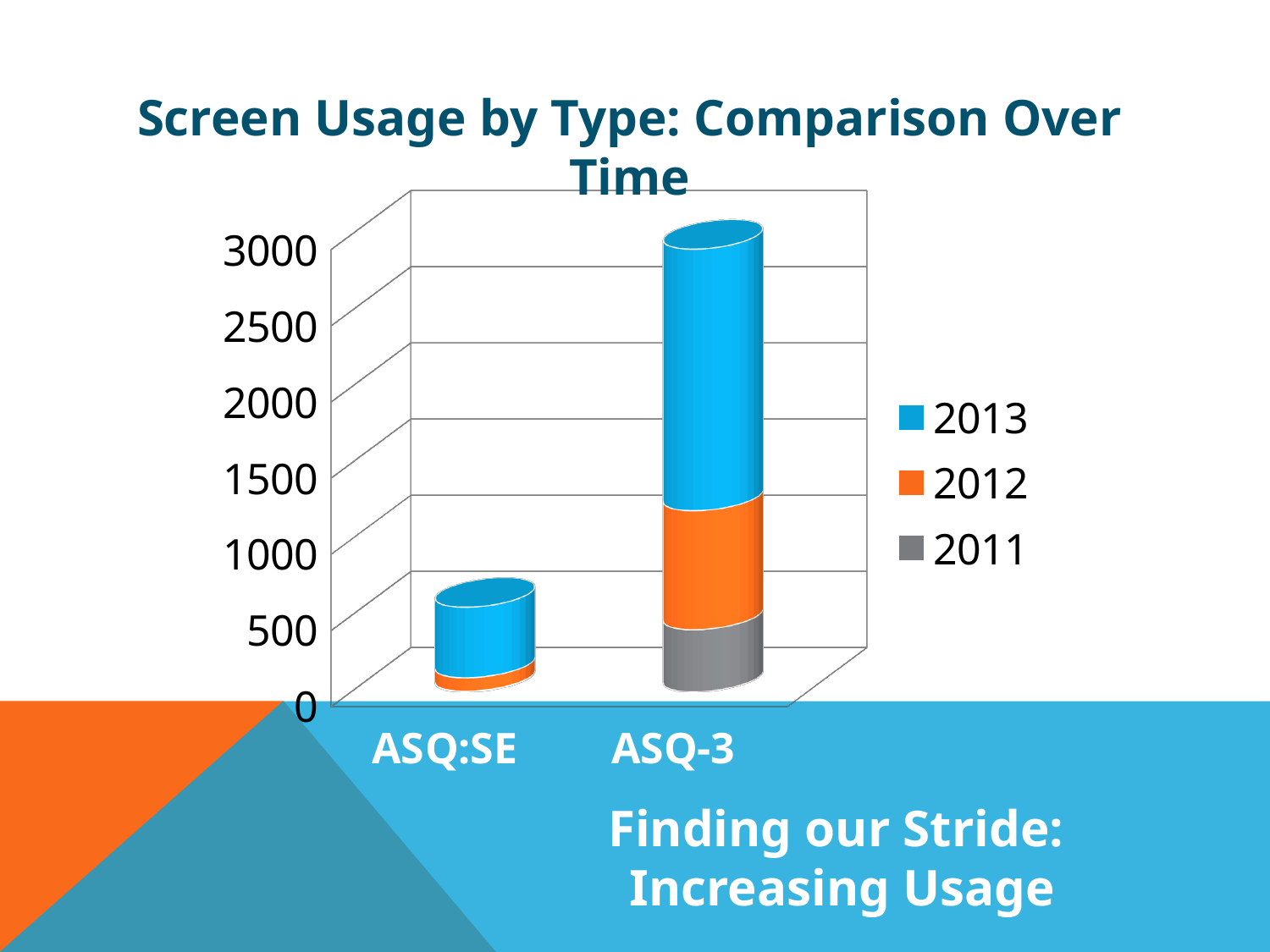
Is the total stacked value for ASQ:SE greater or less than 1000? less Which category has the larger 2013 segment, ASQ:SE or ASQ-3? ASQ-3 Which category has the lowest total stacked value? ASQ:SE Which series is shown at the bottom of each stacked bar? 2011 Which category has the highest total stacked value? ASQ-3 Is the total stacked value for ASQ-3 greater or less than 2000? greater What kind of chart is shown on the slide? Stacked bar chart What is the title of the chart? Screen Usage by Type: Comparison Over Time Which is larger, the total for ASQ-3 or the total for ASQ:SE? ASQ-3 How many categories are shown on the x axis of the chart? 2 How many series does the chart's legend list? 3